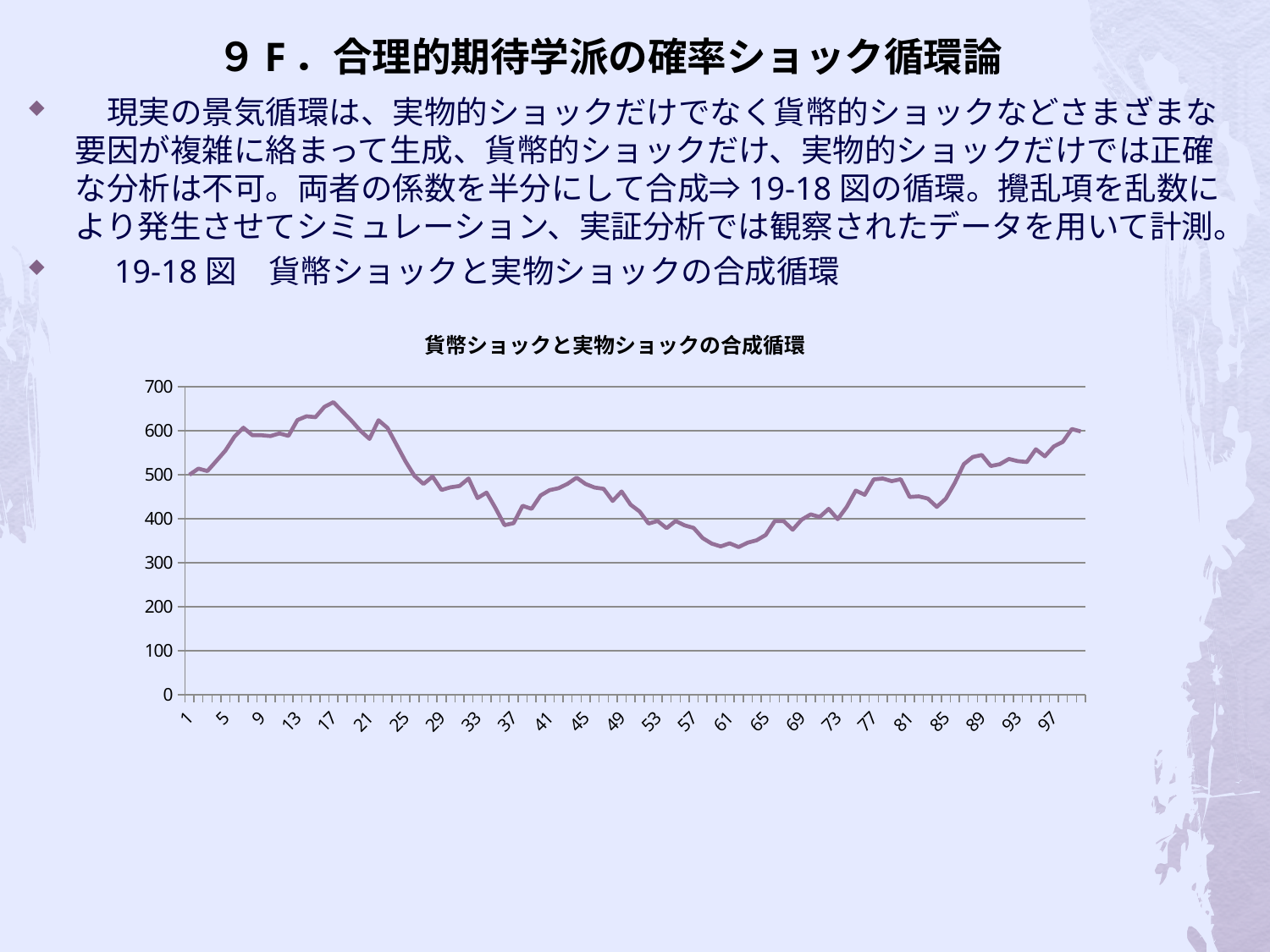
What kind of chart is shown on the slide? line chart Is the value at x = 45 greater or less than 400? greater What is the highest value shown on the chart's y axis? 700 Does the line rise or fall between x = 1 and x = 17? rise Is the value at x = 97 greater or less than 500? greater Is the value at x = 17 greater or less than 600? greater What is the title of the chart? 貨幣ショックと実物ショックの合成循環 Does the line rise or fall between x = 17 and x = 61? fall Does the line rise or fall between x = 61 and x = 97? rise